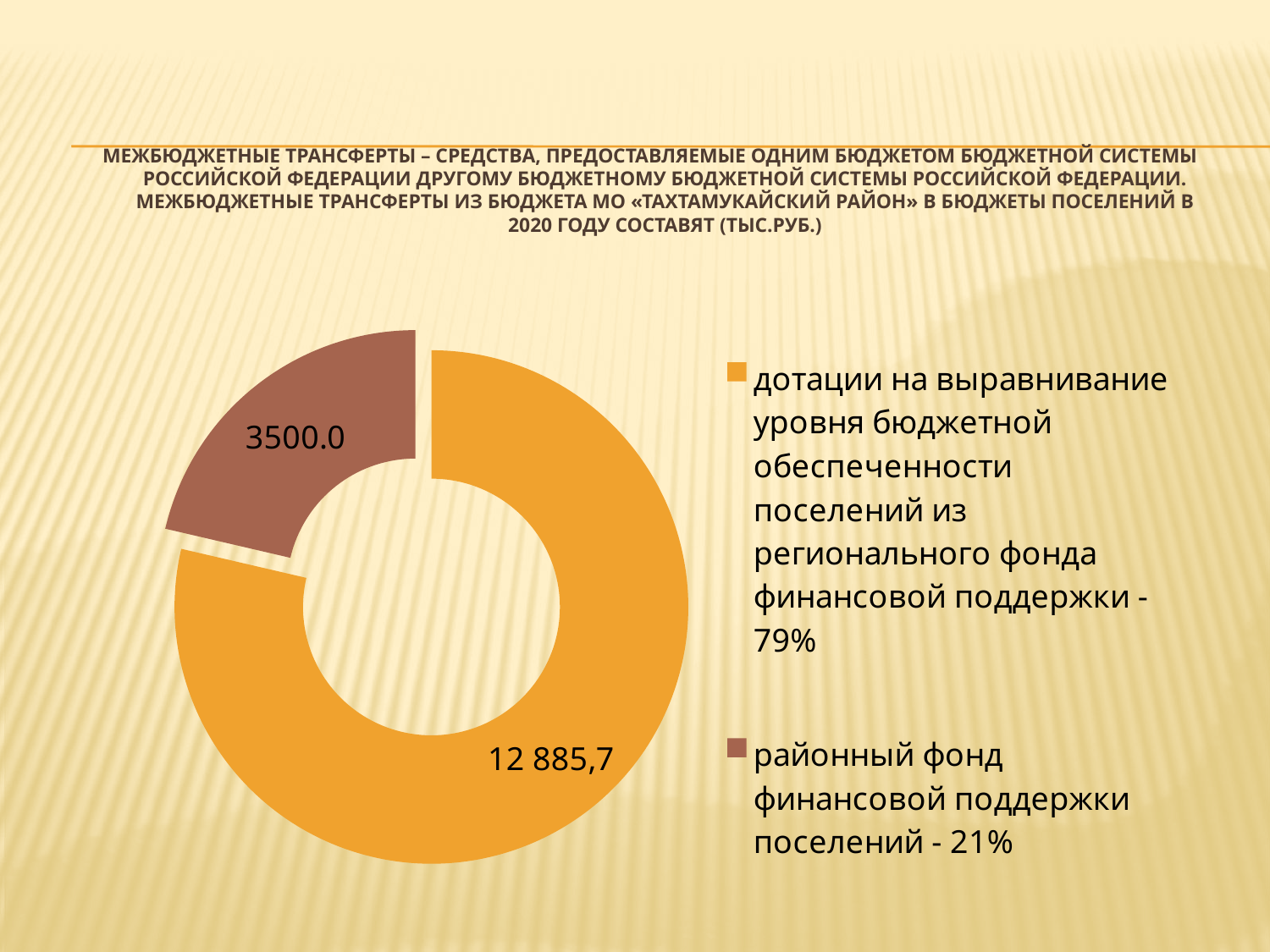
Which slice of the chart is the largest? дотации на выравнивание уровня бюджетной обеспеченности поселений из регионального фонда финансовой поддержки Which slice of the chart is the smallest? районный фонд финансовой поддержки поселений What kind of chart is shown on the slide? doughnut chart Which is larger: the value for 'дотации на выравнивание уровня бюджетной обеспеченности поселений' or for 'районный фонд финансовой поддержки поселений'? дотации на выравнивание уровня бюджетной обеспеченности поселений What is the value for the slice 'дотации на выравнивание уровня бюджетной обеспеченности поселений из регионального фонда финансовой поддержки'? 12 885,7 How many slices does the chart have? 2 What is the value for the slice 'районный фонд финансовой поддержки поселений'? 3500.0 What share of the chart does 'дотации на выравнивание уровня бюджетной обеспеченности поселений из регионального фонда финансовой поддержки' represent? 79% What share of the chart does 'районный фонд финансовой поддержки поселений' represent? 21% What colour is the slice for 'районный фонд финансовой поддержки поселений'? brown In what units are the values on the chart given, according to the slide title? тыс.руб. How many entries does the legend list? 2